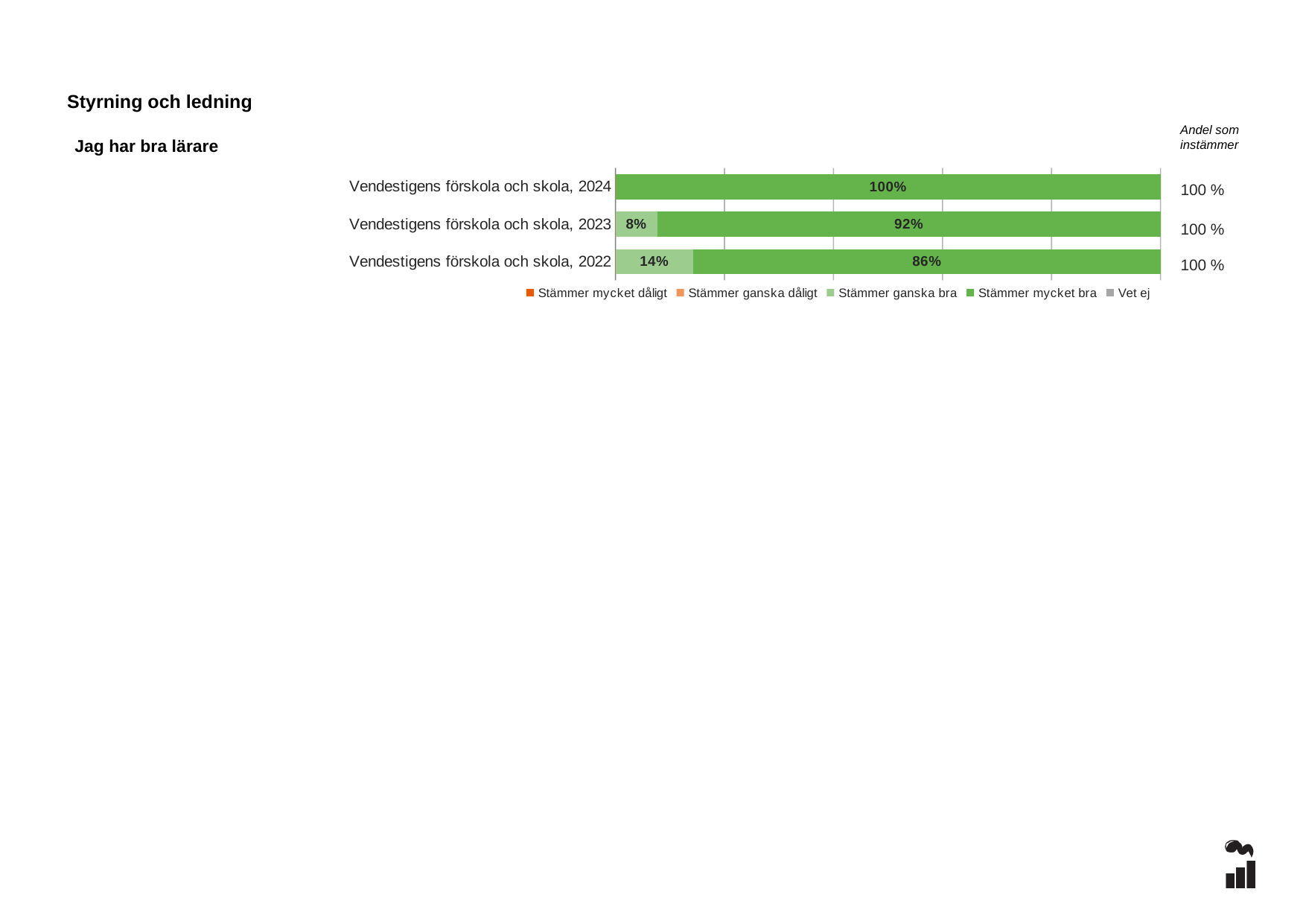
What is the "Andel som instämmer" value shown for Vendestigens förskola och skola, 2022? 100 % What is the value for "Stämmer ganska bra" for Vendestigens förskola och skola, 2023? 8% What is the value for "Stämmer ganska bra" for Vendestigens förskola och skola, 2022? 14% Which year has the highest value for "Stämmer mycket bra"? Vendestigens förskola och skola, 2024 Which is larger: the "Stämmer ganska bra" value for 2022 or for 2023? 2022 What is the value for "Stämmer mycket bra" for Vendestigens förskola och skola, 2024? 100% How many series does the legend list? 5 What kind of chart is shown on the slide? Stacked bar chart How many bars (categories) are shown in the chart? 3 What is the difference between the "Stämmer mycket bra" values for 2023 and 2022? 6% Which year has the lowest value for "Stämmer mycket bra"? Vendestigens förskola och skola, 2022 What is the value for "Stämmer mycket bra" for Vendestigens förskola och skola, 2023? 92%